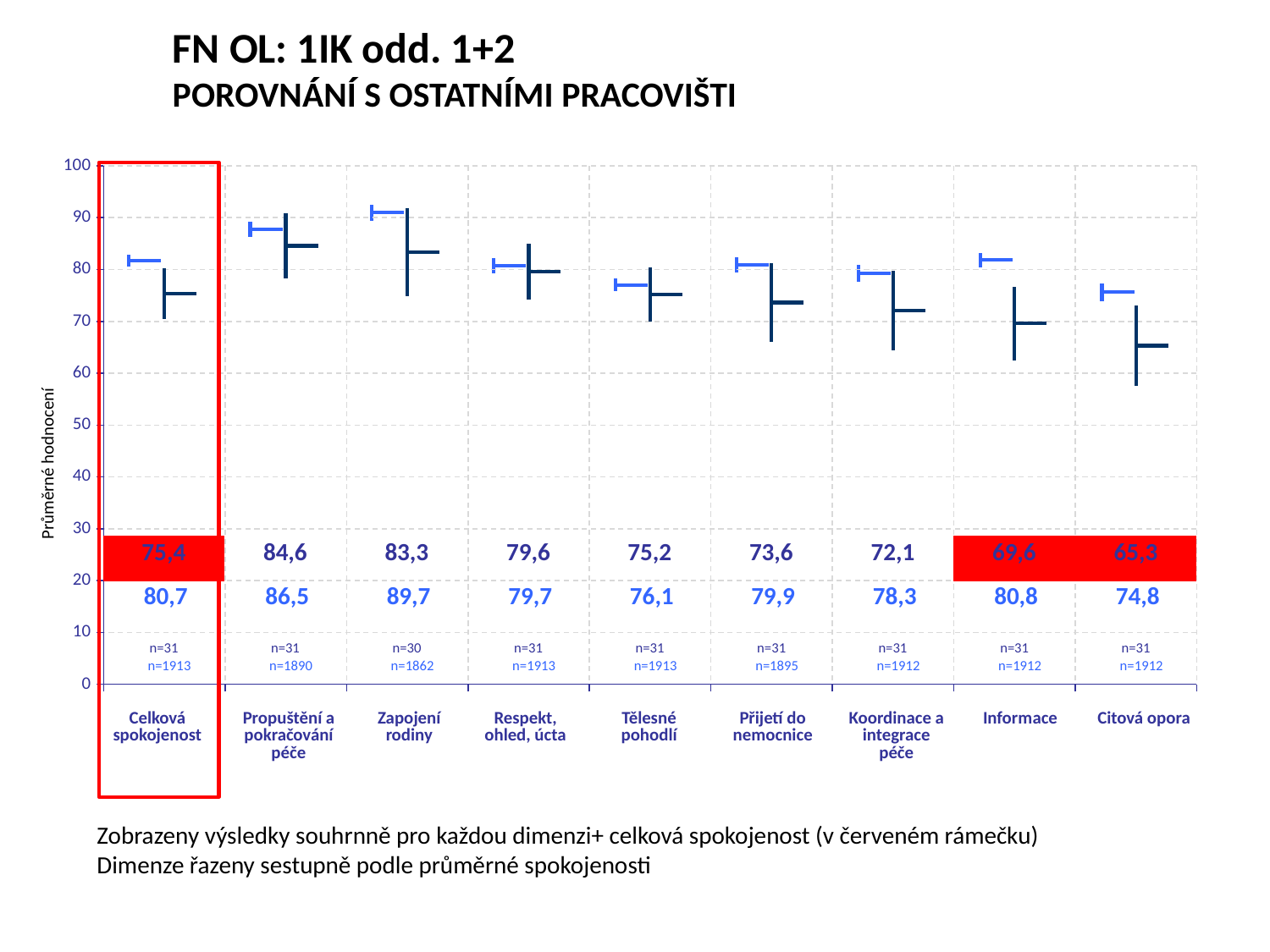
Do the upper values in the first row of numbers rise or fall from Propuštění a pokračování péče to Citová opora? fall What is the difference between the two values printed for Zapojení rodiny (89,7 and 83,3)? 6,4 Which category has the lowest upper value printed in the first row of numbers? Citová opora Which category has the highest upper value printed in the first row of numbers? Propuštění a pokračování péče What is the n value printed on the second line under Celková spokojenost? n=1913 What is the first (upper) value printed for Propuštění a pokračování péče? 84,6 Which is larger: the upper value for Tělesné pohodlí or the upper value for Přijetí do nemocnice? Tělesné pohodlí What is the difference between the two values printed for Informace (80,8 and 69,6)? 11,2 What is the second (lower) value printed for Zapojení rodiny? 89,7 How many categories are shown along the x axis? 9 What is the upper value printed for Citová opora? 65,3 What is the label of the y axis? Průměrné hodnocení